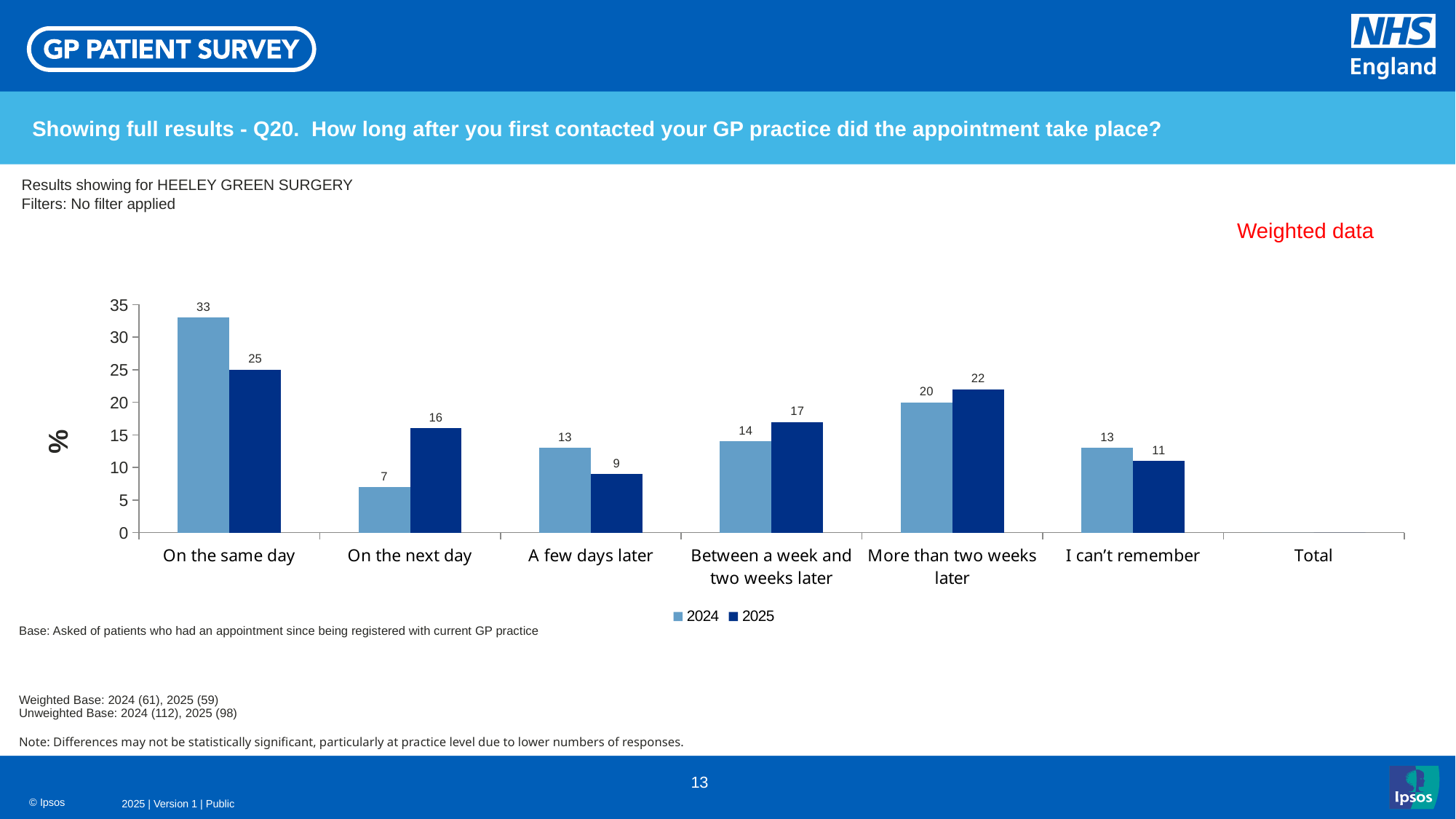
Is the 2025 value for "Between a week and two weeks later" greater or less than 15? greater How many series does the legend list? 2 What is the difference between the 2024 and 2025 values for "On the same day"? 8 Which category has the lowest 2025 value? A few days later Which category has the lowest 2024 value? On the next day What is the 2025 value for "On the next day"? 16 Which category has the highest 2024 value? On the same day What label is shown on the vertical axis? % What is the 2024 value for "On the same day"? 33 What is the 2025 value for "More than two weeks later"? 22 What kind of chart is shown on the slide? Bar chart Which is larger for "A few days later": the 2024 value or the 2025 value? 2024